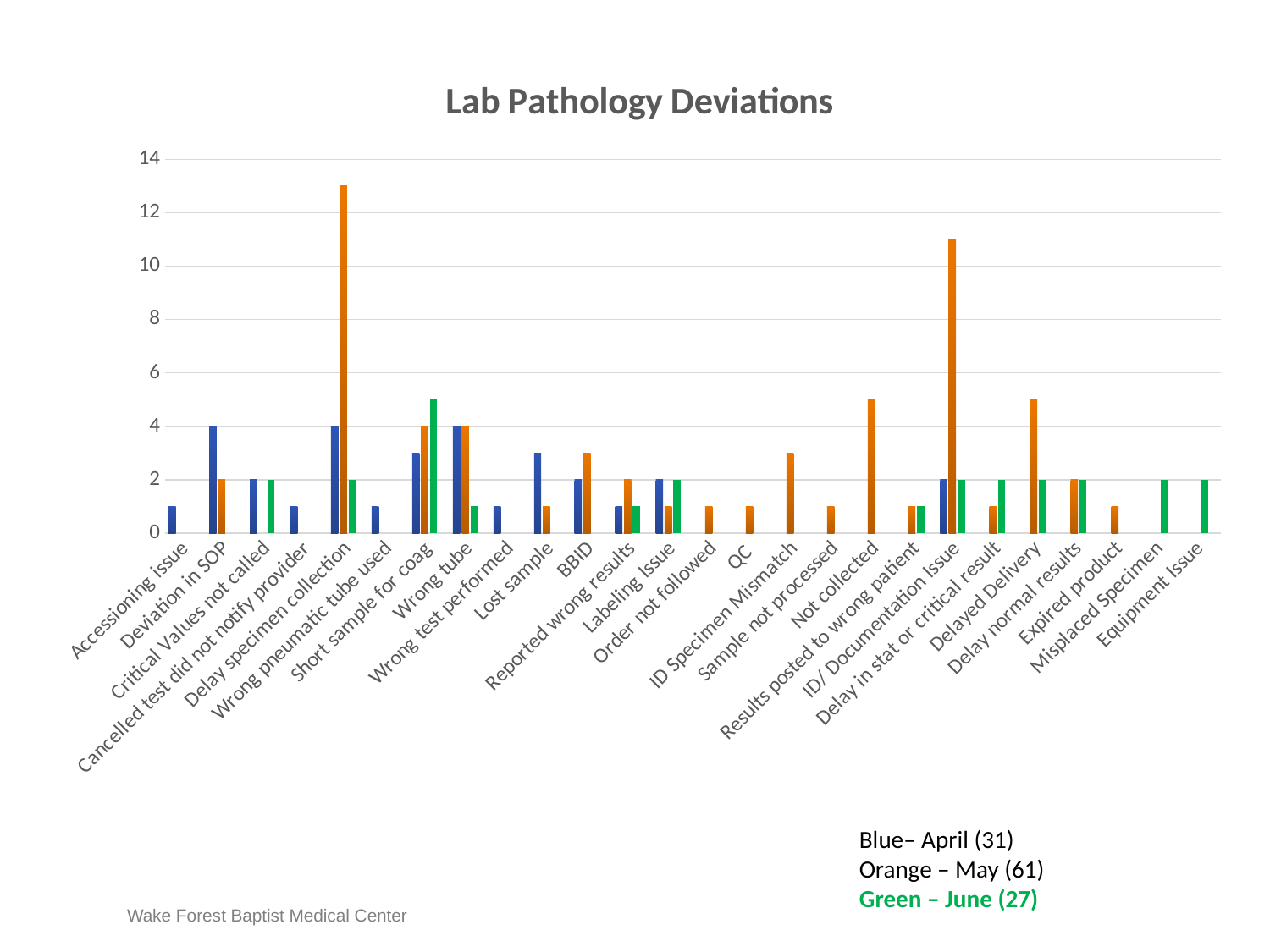
What is the May (orange) value for Wrong tube? 4 What kind of chart is shown on the slide? bar chart Is the May (orange) value for Not collected greater or less than 4? greater What is the June (green) value for Critical Values not called? 2 Is the May (orange) value for Delay specimen collection greater or less than 12? greater What is the April (blue) value for Deviation in SOP? 4 What is the difference between the April (blue) and June (green) values for Delay specimen collection? 2 What is the title of the chart? Lab Pathology Deviations Is the May (orange) value for ID/ Documentation Issue greater or less than 10? greater For Short sample for coag, which month has the larger value, April (blue) or June (green)? June (green) How many series does the colour key below the chart list? 3 Which category has the tallest bar in the chart? Delay specimen collection